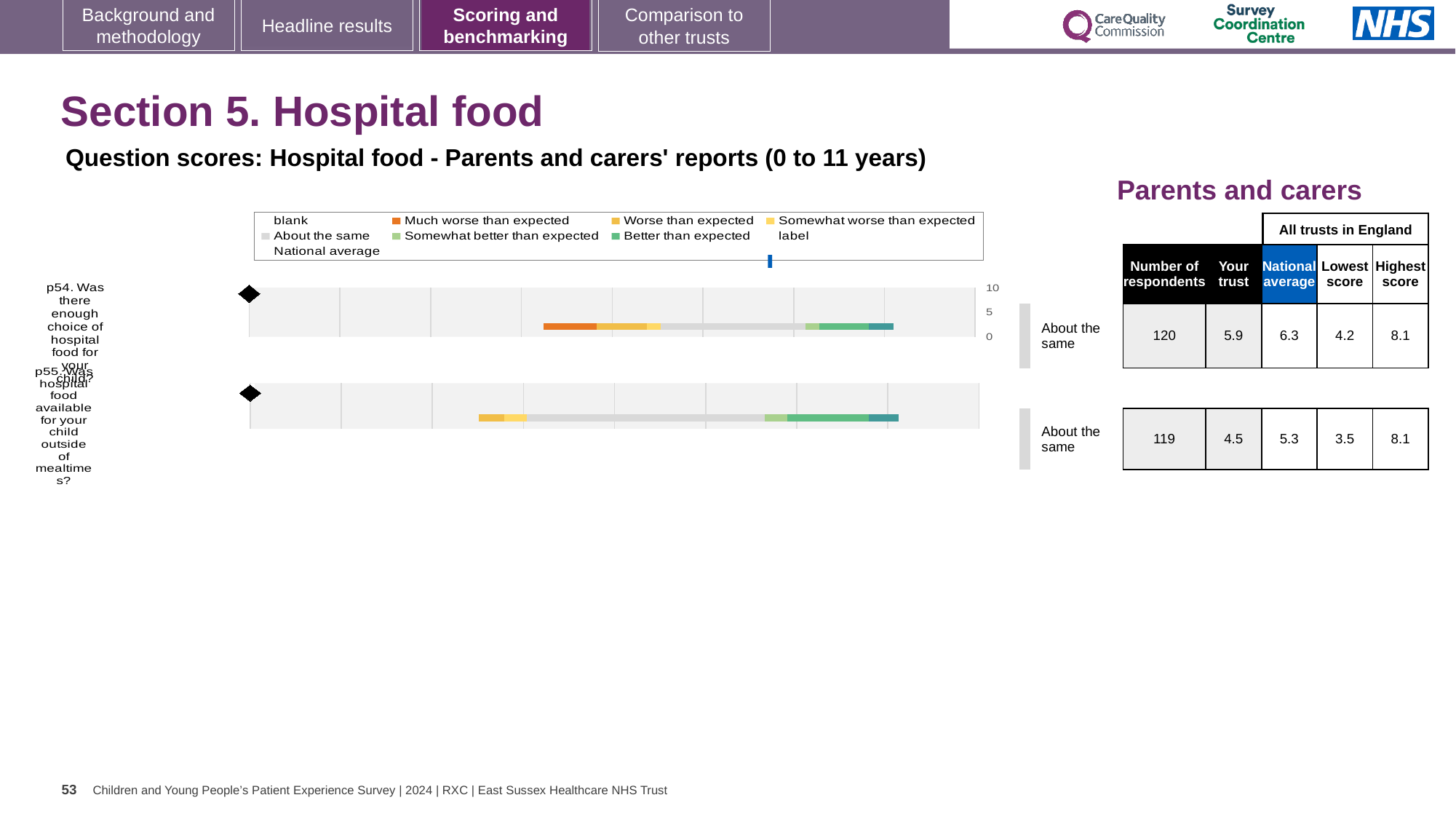
What benchmark category is shown for p55 (food available outside of mealtimes)? About the same What kind of chart is used to show the question scores? Bar chart What is the 'Your trust' score for p55 (hospital food available outside of mealtimes)? 4.5 How many respondents answered question p54 about choice of hospital food? 120 What is the lowest score among all trusts in England for p54? 4.2 What is the difference between the national average and the trust's score for p54? 0.4 How many respondents answered question p55? 119 What is the national average score for p54 (enough choice of hospital food)? 6.3 What is the 'Your trust' score for p54 (enough choice of hospital food)? 5.9 Which question has the higher 'Your trust' score, p54 or p55? p54 What is the highest score among all trusts in England for p55 (food available outside of mealtimes)? 8.1 How many survey questions are plotted on the chart? 2